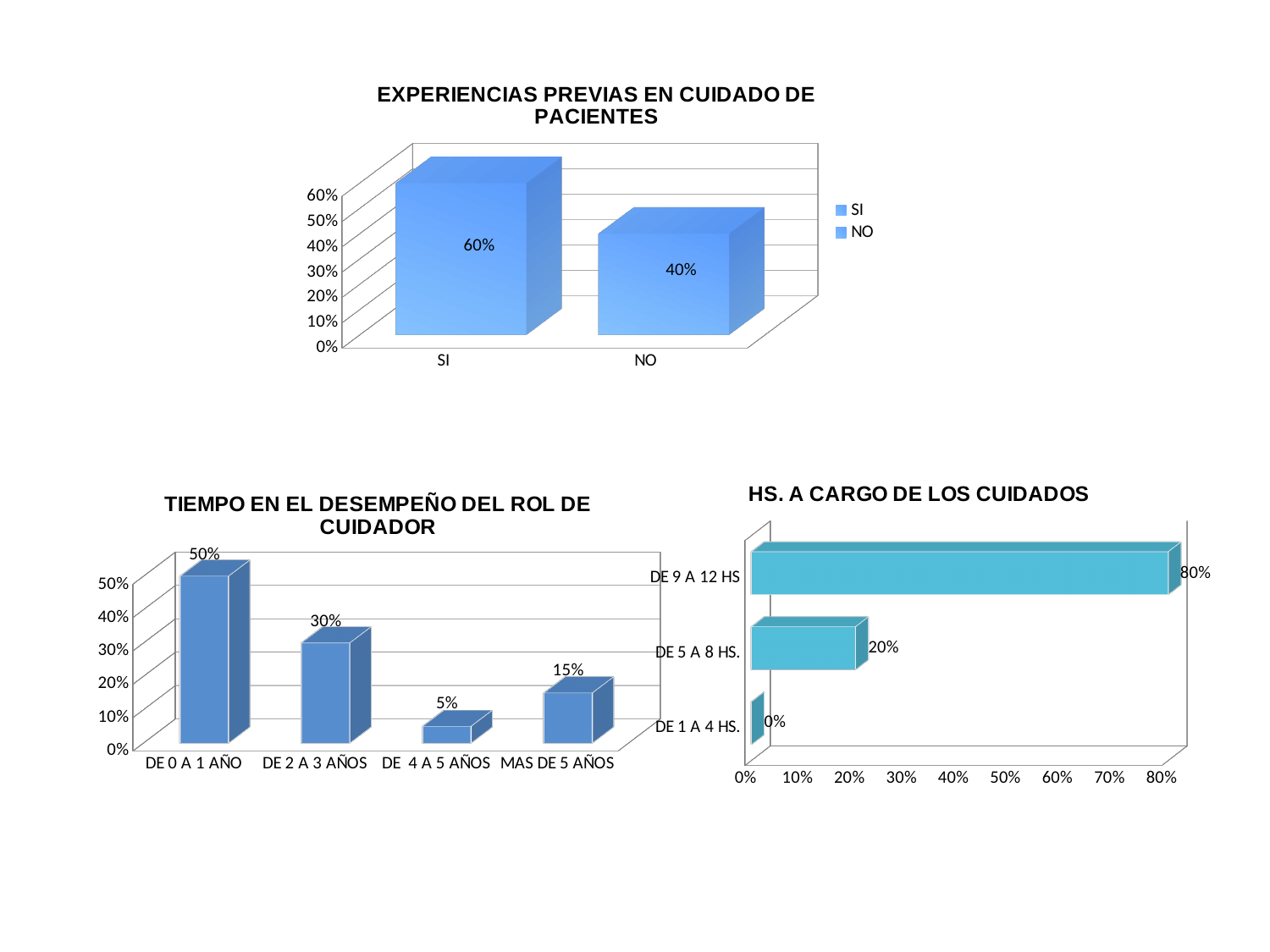
In the chart titled "TIEMPO EN EL DESEMPEÑO DEL ROL DE CUIDADOR", which category has the highest value? DE 0 A 1 AÑO In the chart titled "EXPERIENCIAS PREVIAS EN CUIDADO DE PACIENTES", how many entries does the legend list? 2 In the chart titled "TIEMPO EN EL DESEMPEÑO DEL ROL DE CUIDADOR", which is larger: the value for DE 4 A 5 AÑOS or MAS DE 5 AÑOS? MAS DE 5 AÑOS In the chart titled "HS. A CARGO DE LOS CUIDADOS", what is the difference between the values for DE 9 A 12 HS and DE 5 A 8 HS.? 60% What kind of chart is the one titled "HS. A CARGO DE LOS CUIDADOS"? Bar chart In the chart titled "TIEMPO EN EL DESEMPEÑO DEL ROL DE CUIDADOR", what is the value for DE 2 A 3 AÑOS? 30% In the chart titled "TIEMPO EN EL DESEMPEÑO DEL ROL DE CUIDADOR", how many categories are shown on the x axis? 4 In the chart titled "EXPERIENCIAS PREVIAS EN CUIDADO DE PACIENTES", what is the difference between the SI and NO values? 20% In the chart titled "HS. A CARGO DE LOS CUIDADOS", what is the value for DE 5 A 8 HS.? 20% In the chart titled "TIEMPO EN EL DESEMPEÑO DEL ROL DE CUIDADOR", which category has the lowest value? DE 4 A 5 AÑOS In the chart titled "HS. A CARGO DE LOS CUIDADOS", what is the value for DE 1 A 4 HS.? 0% In the chart titled "EXPERIENCIAS PREVIAS EN CUIDADO DE PACIENTES", what is the value for SI? 60%